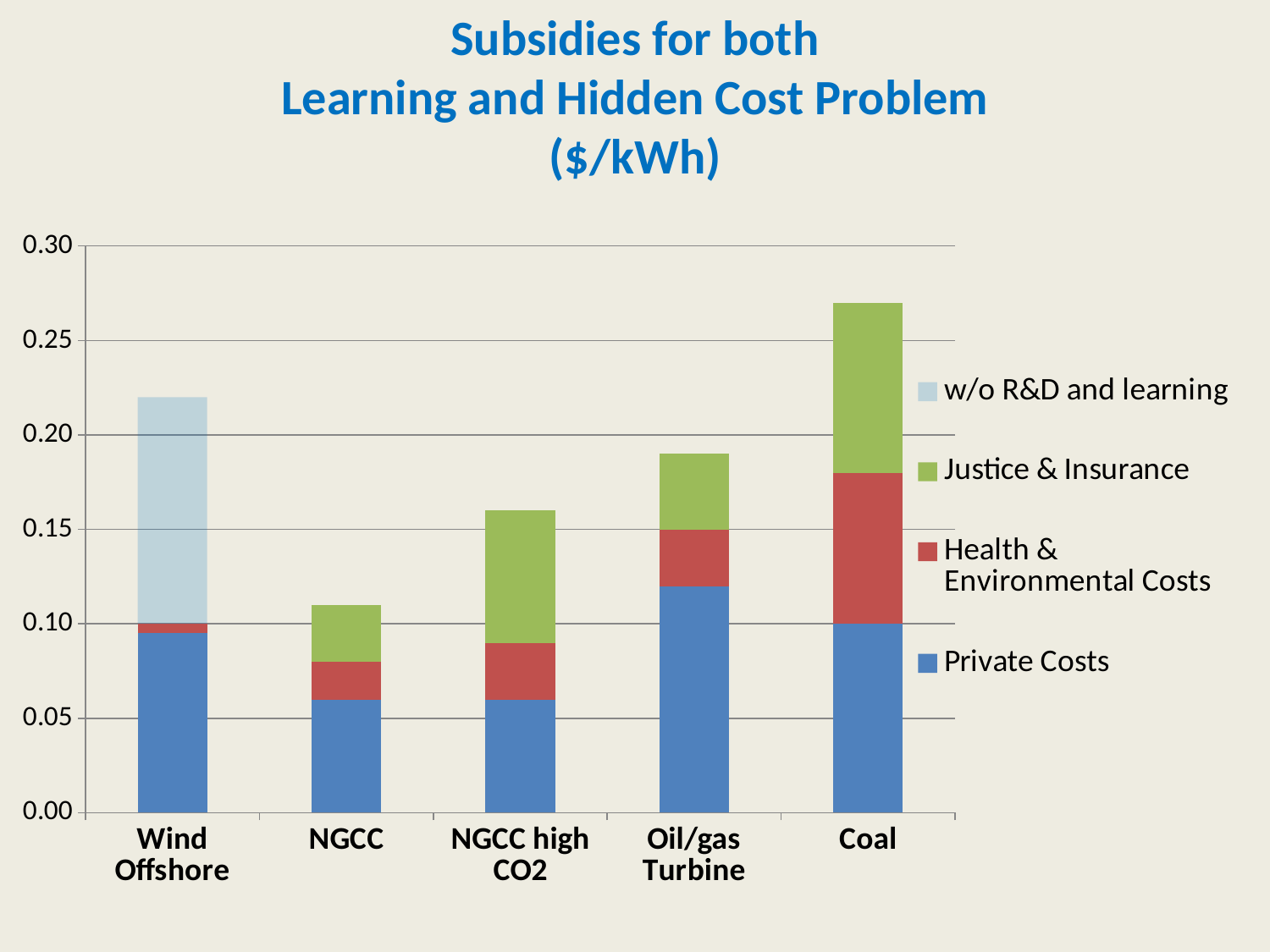
Which category has the highest total stacked bar? Coal Is the total value for Coal greater or less than 0.25? greater What kind of chart is shown on the slide? bar chart Is the total value for NGCC greater or less than 0.15? less Is the total value for Wind Offshore greater or less than 0.20? greater How many series does the legend list? 4 Which category has the lowest total stacked bar? NGCC How many categories are shown on the x axis of the chart? 5 Which category is the only one with a 'w/o R&D and learning' segment? Wind Offshore Which has the larger total stacked bar, Oil/gas Turbine or NGCC high CO2? Oil/gas Turbine What colour represents Private Costs in the chart? blue